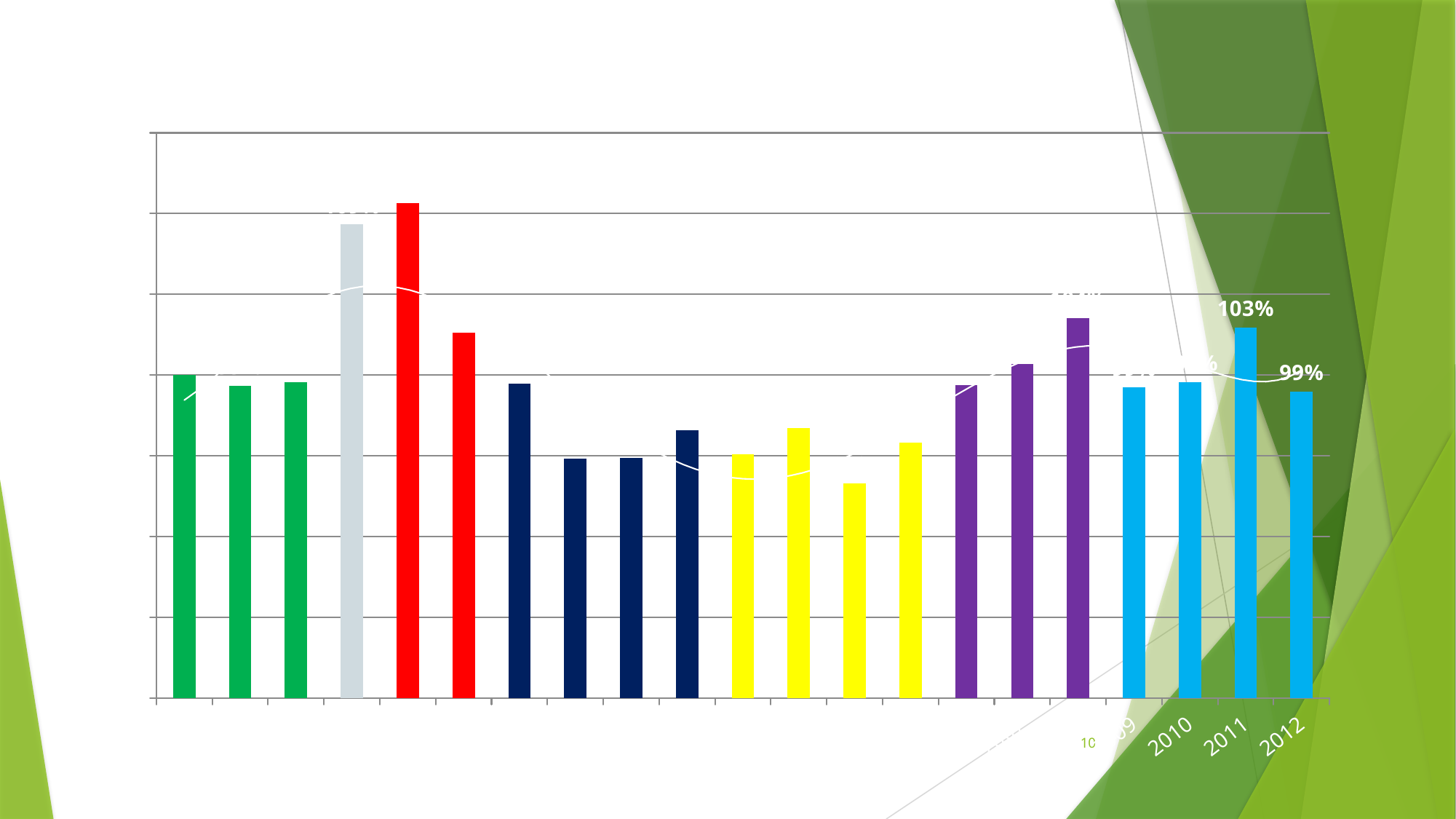
What colour is the tallest bar in the chart? red Does the value fall or rise from 2011 to 2012? fall How many bars are plotted in the chart? 21 What kind of chart is shown on the slide? bar chart What is the difference between the values for 2011 and 2012? 4% What is the value shown for 2012? 99% Which is larger, the value for 2011 or the value for 2012? 2011 What is the value shown for 2011? 103% What colour are the bars for 2010, 2011 and 2012? light blue